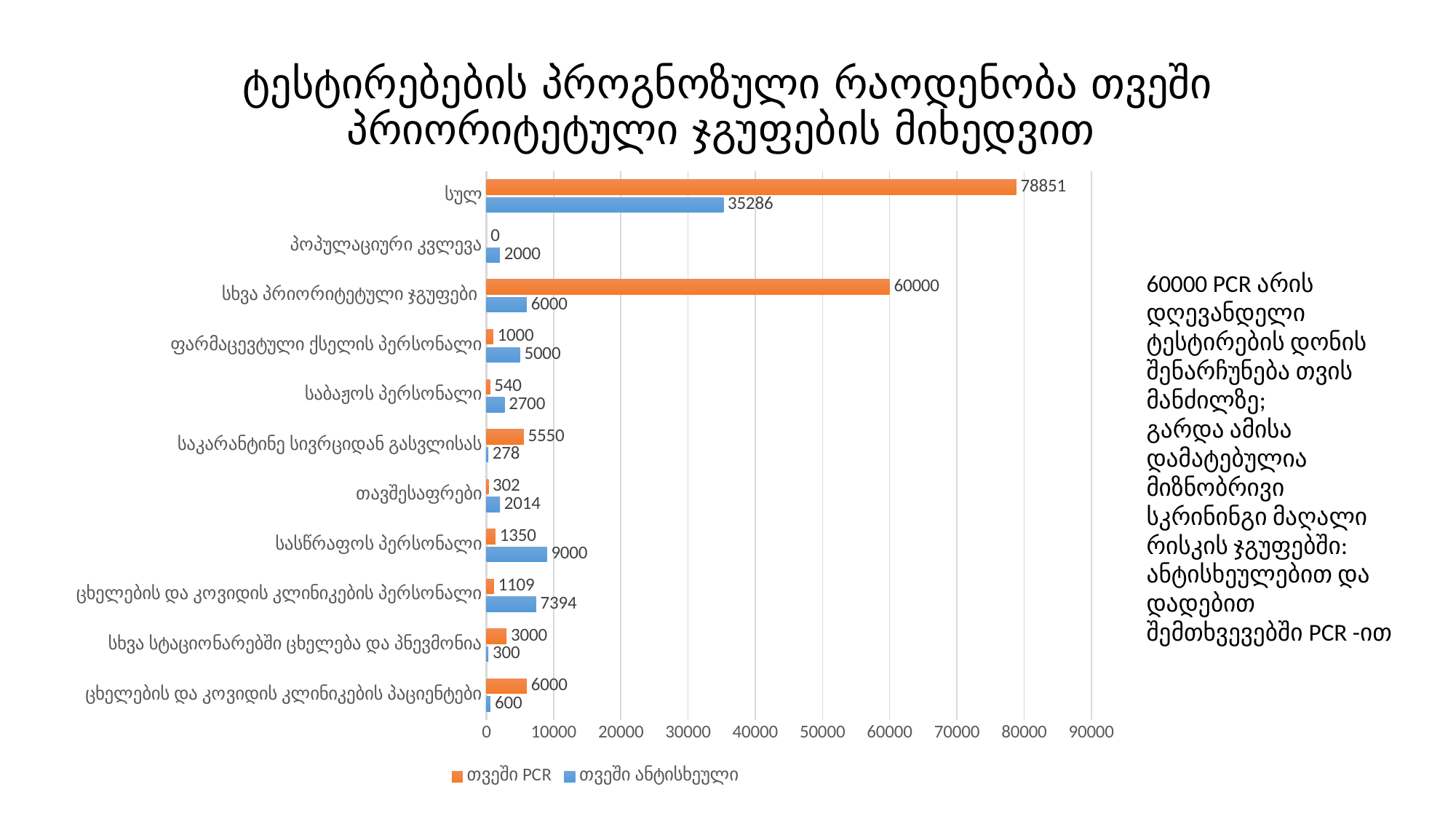
Excluding სულ, which category has the highest თვეში PCR value? სხვა პრიორიტეტული ჯგუფები Which series is shown in orange? თვეში PCR What is the value of თვეში PCR for სულ? 78851 What is the value of თვეში ანტისხეული for ცხელების და კოვიდის კლინიკების პერსონალი? 7394 What is the difference between the თვეში PCR and თვეში ანტისხეული values for სულ? 43565 For საბაჟოს პერსონალი, which is larger: თვეში PCR or თვეში ანტისხეული? თვეში ანტისხეული How many categories are shown on the chart? 11 What type of chart is shown on the slide? bar chart Which category has the lowest თვეში PCR value? პოპულაციური კვლევა What is the value of თვეში PCR for საკარანტინე სივრციდან გასვლისას? 5550 How many series does the legend list? 2 What is the value of თვეში ანტისხეული for სასწრაფოს პერსონალი? 9000